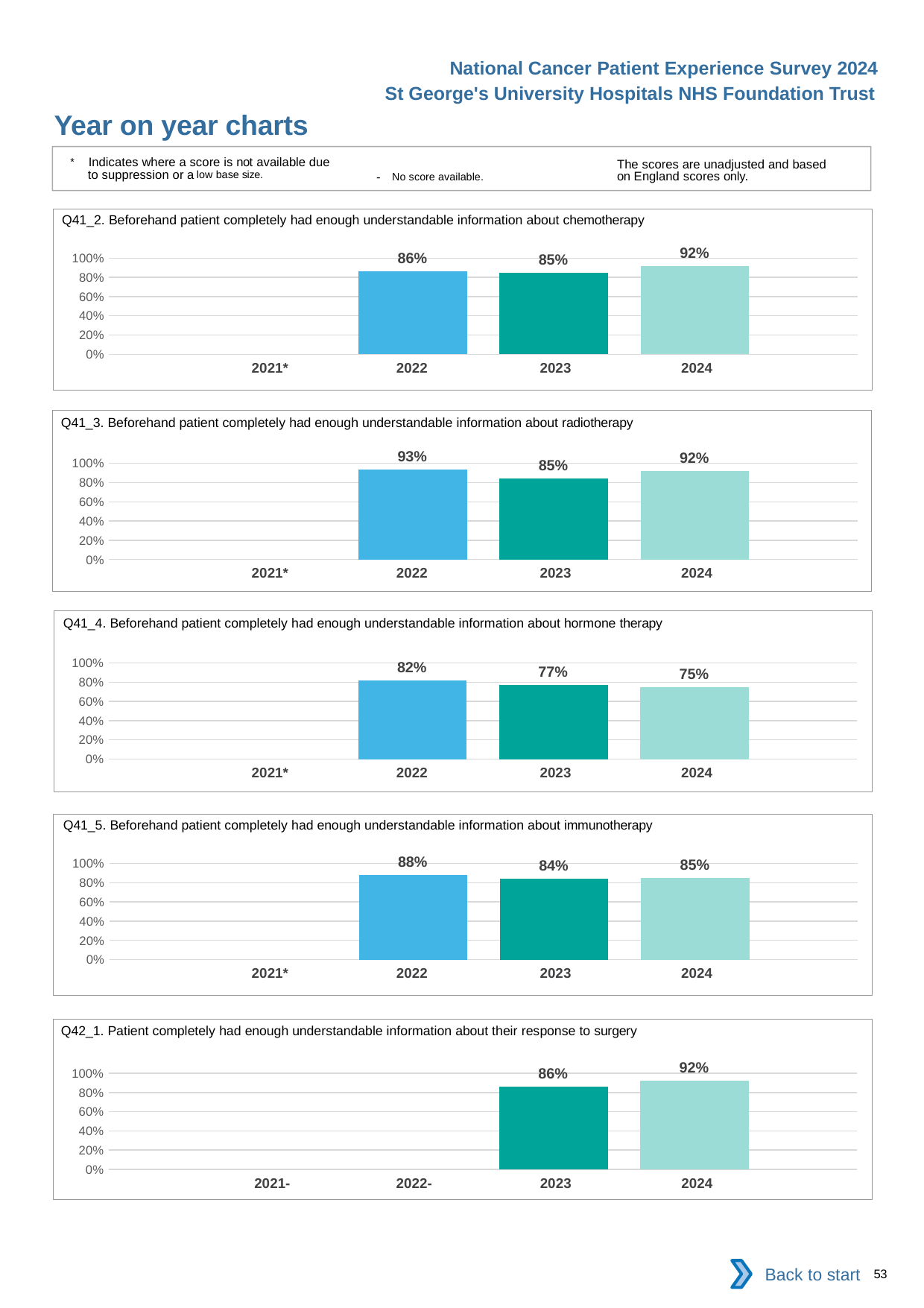
What kind of chart is the Q41_3 chart (radiotherapy)? bar chart In the Q41_4 chart (hormone therapy), do the values rise or fall from 2022 to 2024? fall In the Q42_1 chart (response to surgery), what is the value for 2023? 86% In the Q42_1 chart (response to surgery), how many years have a bar plotted? 2 In the Q41_4 chart (hormone therapy), which year has the lowest value? 2024 In the Q41_2 chart (chemotherapy), which is larger, the 2022 value or the 2023 value? 2022 In the Q41_2 chart (chemotherapy), what is the value for 2024? 92% In the Q41_3 chart (radiotherapy), what is the difference between the 2022 and 2023 values? 8% How many charts are shown on the slide? 5 In the Q41_4 chart (hormone therapy), what is the value for 2023? 77% In the Q41_5 chart (immunotherapy), what is the difference between the 2022 and 2023 values? 4% In the Q41_3 chart (radiotherapy), which year has the highest value? 2022